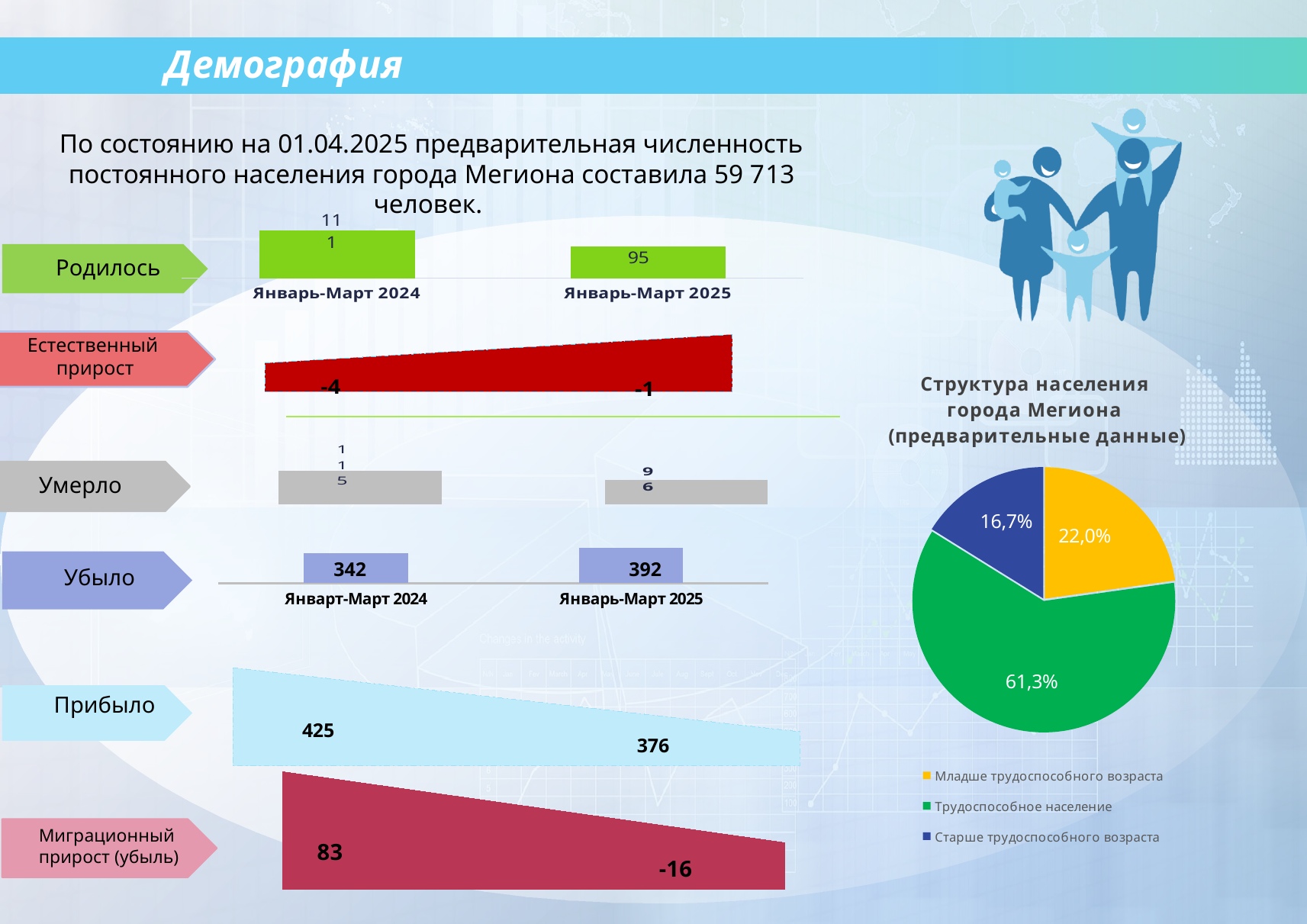
In the 'Миграционный прирост (убыль)' chart, what is the value for Январь-Март 2025? -16 In the 'Прибыло' chart, what is the value for Январь-Март 2024? 425 In the pie chart 'Структура населения города Мегиона', what share is shown for 'Младше трудоспособного возраста'? 22,0% In the 'Прибыло' chart, which period has the larger value, Январь-Март 2024 or Январь-Март 2025? Январь-Март 2024 In the pie chart 'Структура населения города Мегиона', which category has the largest slice? Трудоспособное население In the pie chart 'Структура населения города Мегиона', what share is shown for 'Старше трудоспособного возраста'? 16,7% In the 'Естественный прирост' chart, what is the value for Январь-Март 2024? -4 In the 'Убыло' chart, what is the value for Январь-Март 2025? 392 In the 'Родилось' chart, what is the value for Январь-Март 2025? 95 In the 'Убыло' chart, what is the difference between the Январь-Март 2025 and Январь-Март 2024 values? 50 How many entries does the legend of the pie chart 'Структура населения города Мегиона' list? 3 In the pie chart 'Структура населения города Мегиона', what share is labelled for the green slice (Трудоспособное население)? 61,3%